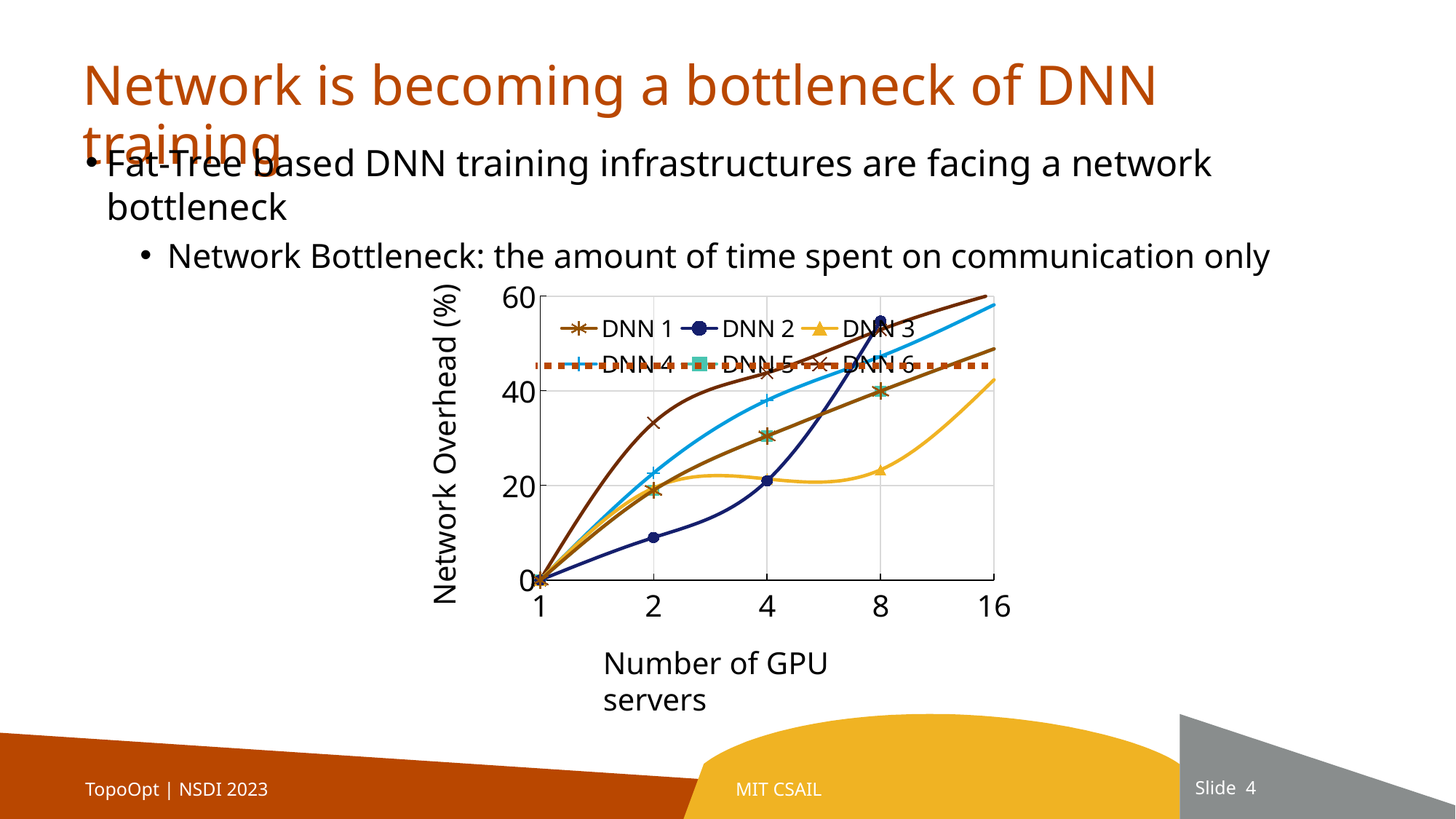
Is the value for DNN 3 at 8 GPU servers greater or less than 40? less How many values of Number of GPU servers are marked on the x axis? 5 Is the value for DNN 2 at 8 GPU servers greater or less than 40? greater Is the value for DNN 2 at 2 GPU servers greater or less than 20? less What is the label of the y axis? Network Overhead (%) Does the Network Overhead for DNN 2 rise or fall as the number of GPU servers increases? rise How many series does the legend list? 6 What kind of chart is shown on the slide? line chart At 2 GPU servers, which has the higher Network Overhead, DNN 6 or DNN 2? DNN 6 What is the label of the x axis? Number of GPU servers At 8 GPU servers, which series has the lowest Network Overhead? DNN 3